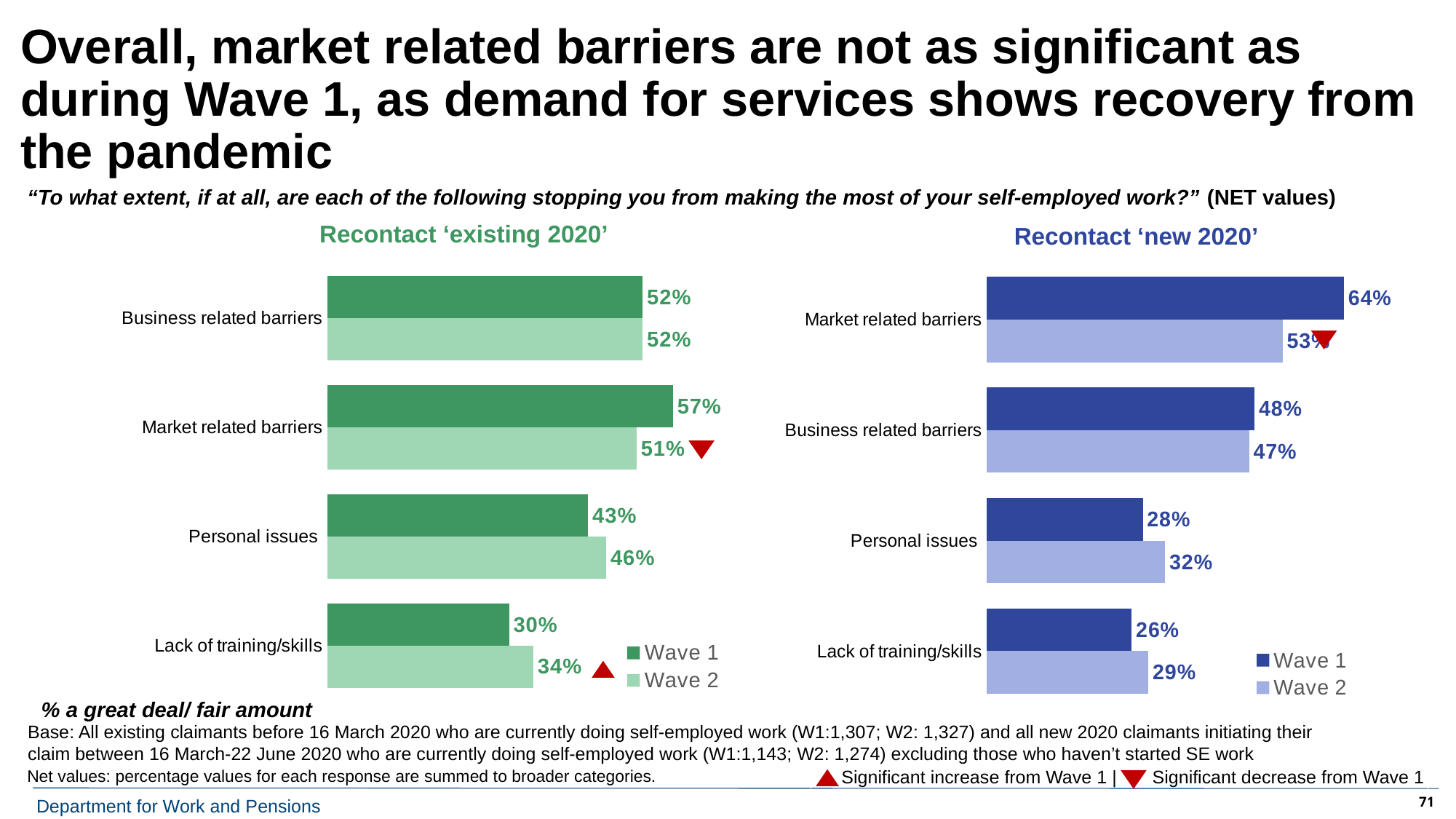
How many series does the legend of the 'Recontact ‘existing 2020’' chart list? 2 In the 'Recontact ‘existing 2020’' chart, what is the difference between the Wave 1 and Wave 2 values for Lack of training/skills? 4 percentage points In the 'Recontact ‘new 2020’' chart, what is the difference between the Wave 1 and Wave 2 values for Market related barriers? 11 percentage points In the 'Recontact ‘existing 2020’' chart, which category has the lowest Wave 2 value? Lack of training/skills In the 'Recontact ‘new 2020’' chart, which category has the highest Wave 1 value? Market related barriers What type of chart is the 'Recontact ‘new 2020’' chart? Bar chart In the 'Recontact ‘existing 2020’' chart, what is the Wave 1 value for Market related barriers? 57% In the 'Recontact ‘existing 2020’' chart, which is larger for Personal issues: the Wave 1 value or the Wave 2 value? Wave 2 In the 'Recontact ‘existing 2020’' chart, what is the Wave 2 value for Lack of training/skills? 34% In the 'Recontact ‘new 2020’' chart, what is the Wave 2 value for Personal issues? 32% How many categories are shown in the 'Recontact ‘new 2020’' chart? 4 In the 'Recontact ‘new 2020’' chart, what is the Wave 1 value for Business related barriers? 48%